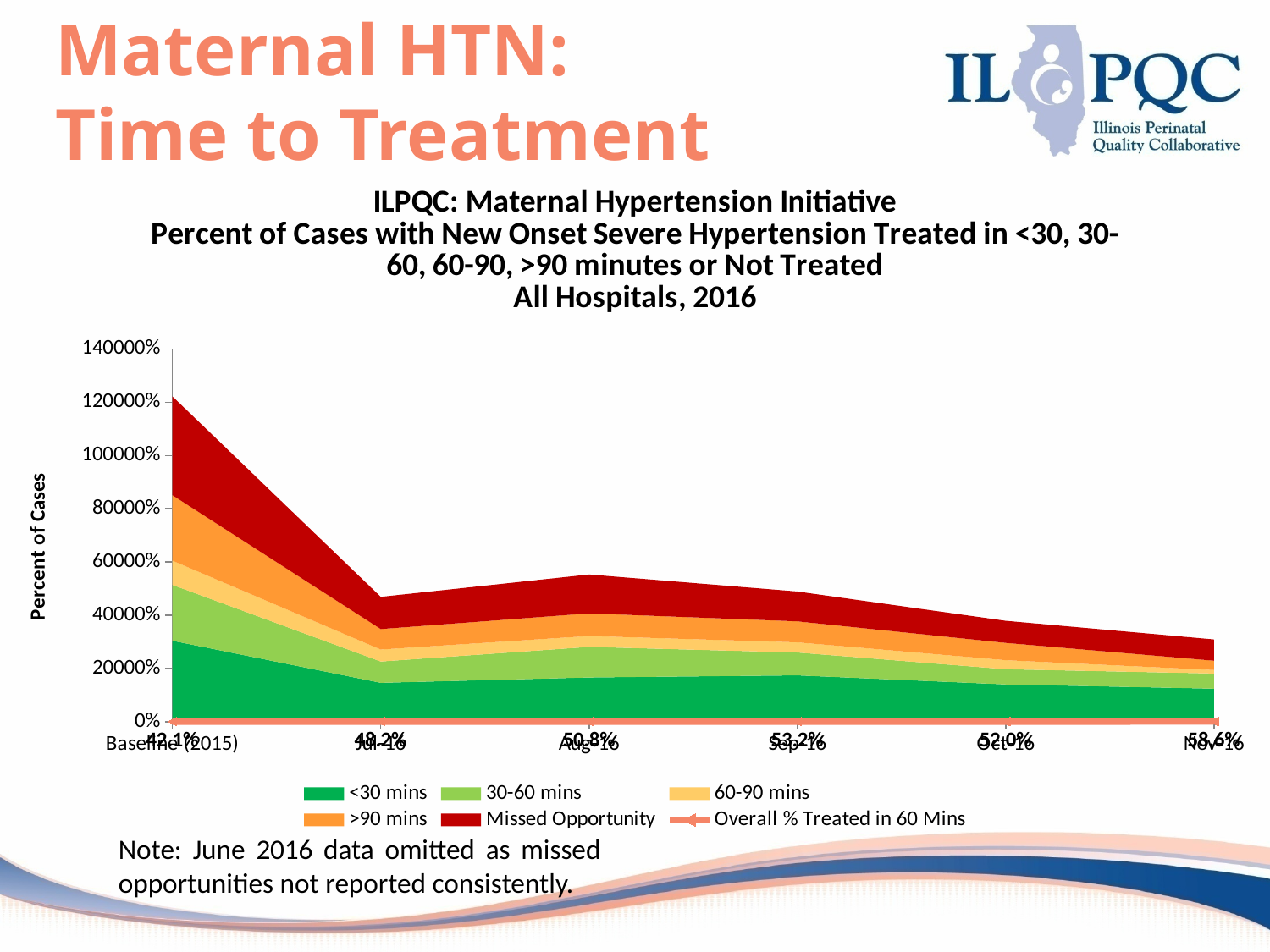
How many series does the legend list? 6 Which time point has the highest Overall % Treated in 60 Mins? Nov-16 What is the Overall % Treated in 60 Mins value at Baseline (2015)? 42.1% Which time point has the lowest Overall % Treated in 60 Mins? Baseline (2015) Which series is shown in dark red in the legend? Missed Opportunity Does the Overall % Treated in 60 Mins generally rise or fall from Baseline (2015) to Nov-16? rise By how many percentage points does the Overall % Treated in 60 Mins for Nov-16 exceed the Baseline (2015) value? 16.5 percentage points How many time points are shown on the x axis? 6 What is the Overall % Treated in 60 Mins value for Nov-16? 58.6% What is the Overall % Treated in 60 Mins value for Jul-16? 48.2% What is the Overall % Treated in 60 Mins value for Sep-16? 53.2% Which has a higher Overall % Treated in 60 Mins, Sep-16 or Oct-16? Sep-16